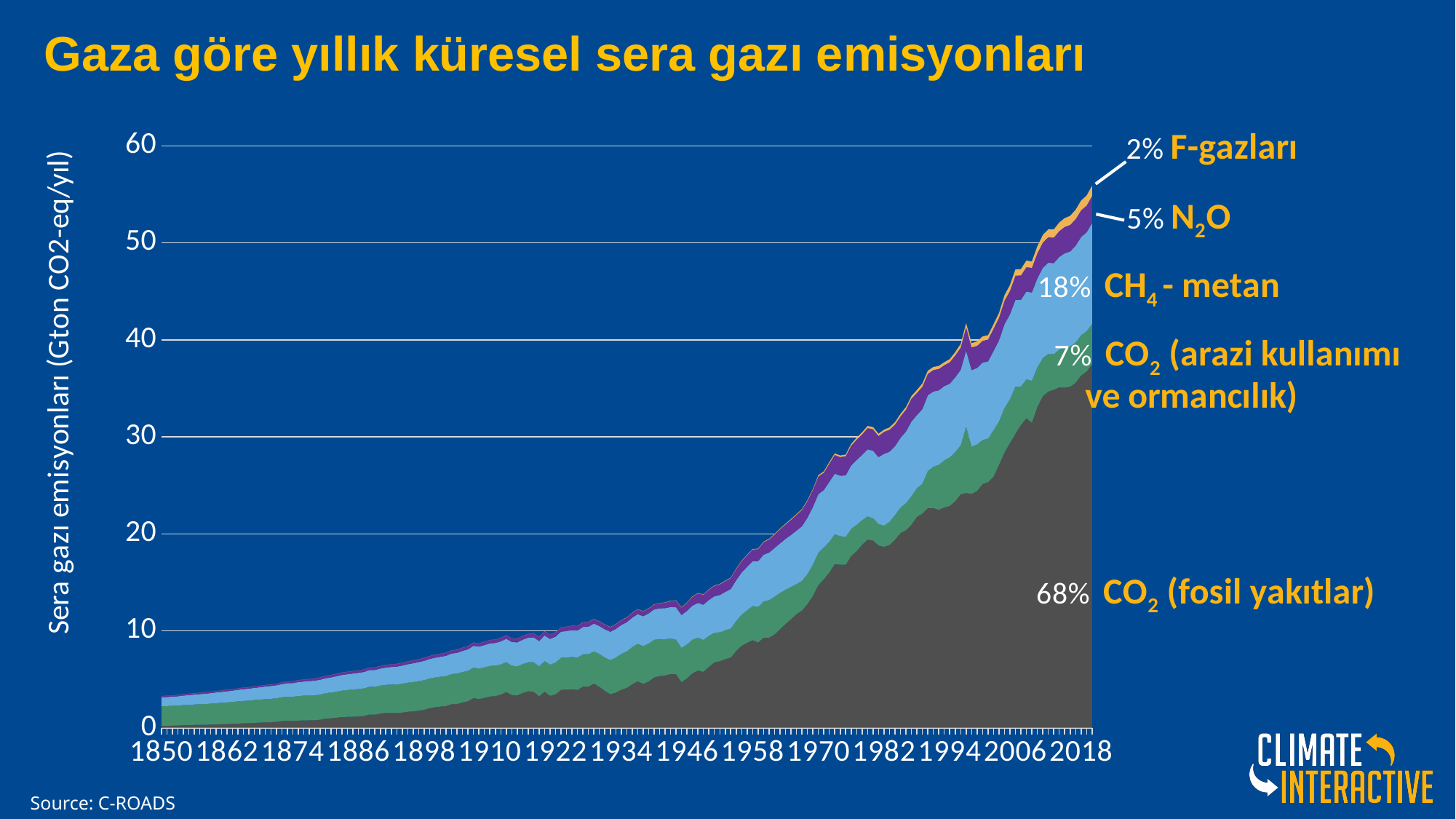
Which gas category has the largest labelled share? CO2 (fosil yakıtlar) Do total emissions generally rise or fall from 1850 to 2018? rise What percentage share is labelled for CO2 (fosil yakıtlar)? 68% What kind of chart is shown on the slide? Stacked area chart How many gas categories (series) are labelled on the chart? 5 Is the total emissions value at the right end of the chart (2018) greater or less than 50? greater Which gas category has the smallest labelled share? F-gazları What is the difference in percentage points between the share of CO2 (fosil yakıtlar) and CH4 - metan? 50 percentage points What is the title of the chart? Gaza göre yıllık küresel sera gazı emisyonları What percentage share is labelled for N2O? 5% What percentage share is labelled for F-gazları? 2% What percentage share is labelled for CH4 - metan? 18%